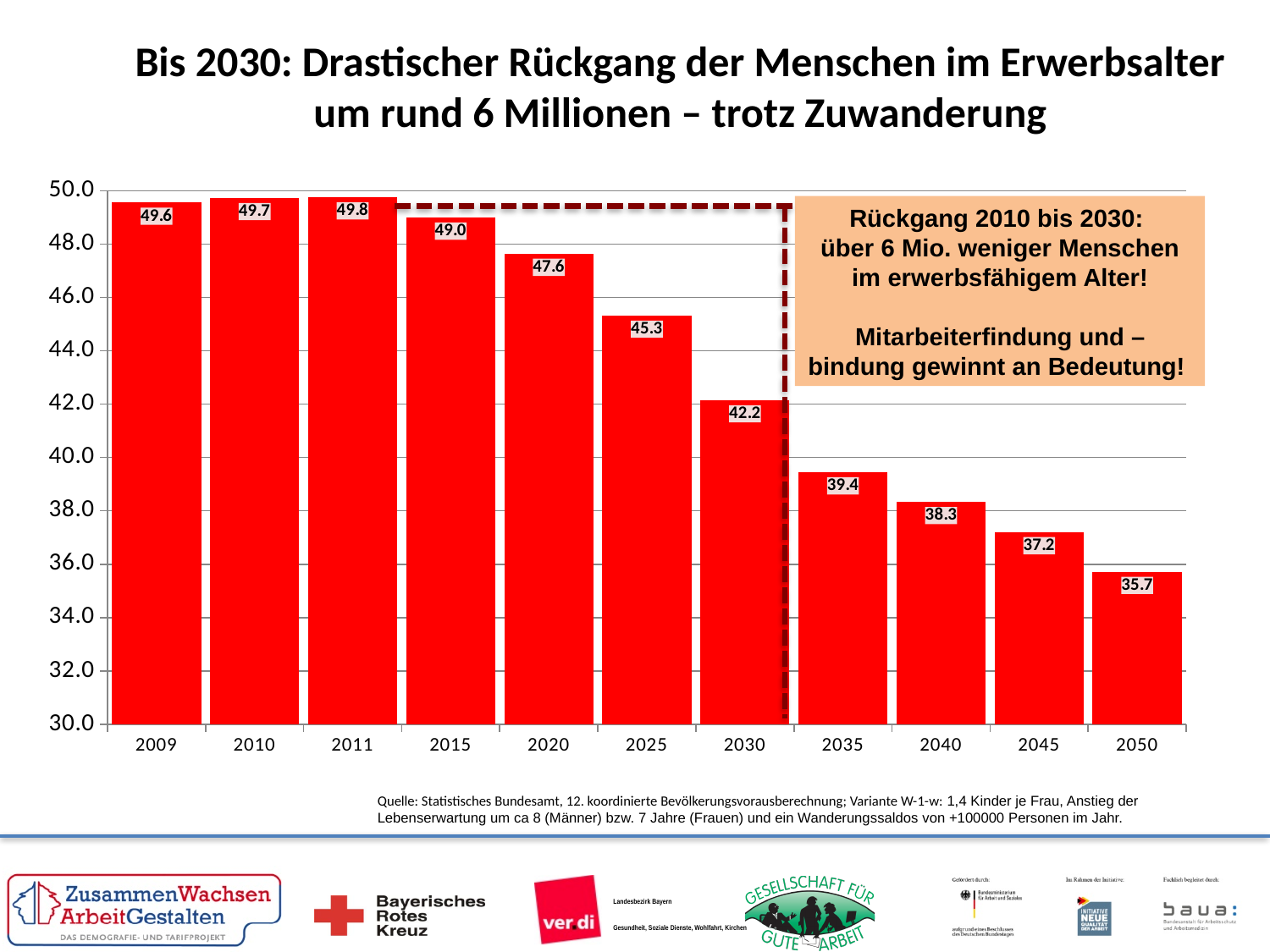
What is the value for 2030? 42.2 What is the value for 2050? 35.7 Which is larger, the value for 2015 or the value for 2035? 2015 Which year has the lowest value? 2050 Which year has the highest value? 2011 What kind of chart is shown on the slide? bar chart How many years are shown on the x axis? 11 What is the difference between the values for 2020 and 2025? 2.3 Do the values rise or fall from 2011 to 2050? fall What is the difference between the values for 2010 and 2030? 7.5 Is the value for 2040 greater or less than 40.0? less What is the value for 2009? 49.6